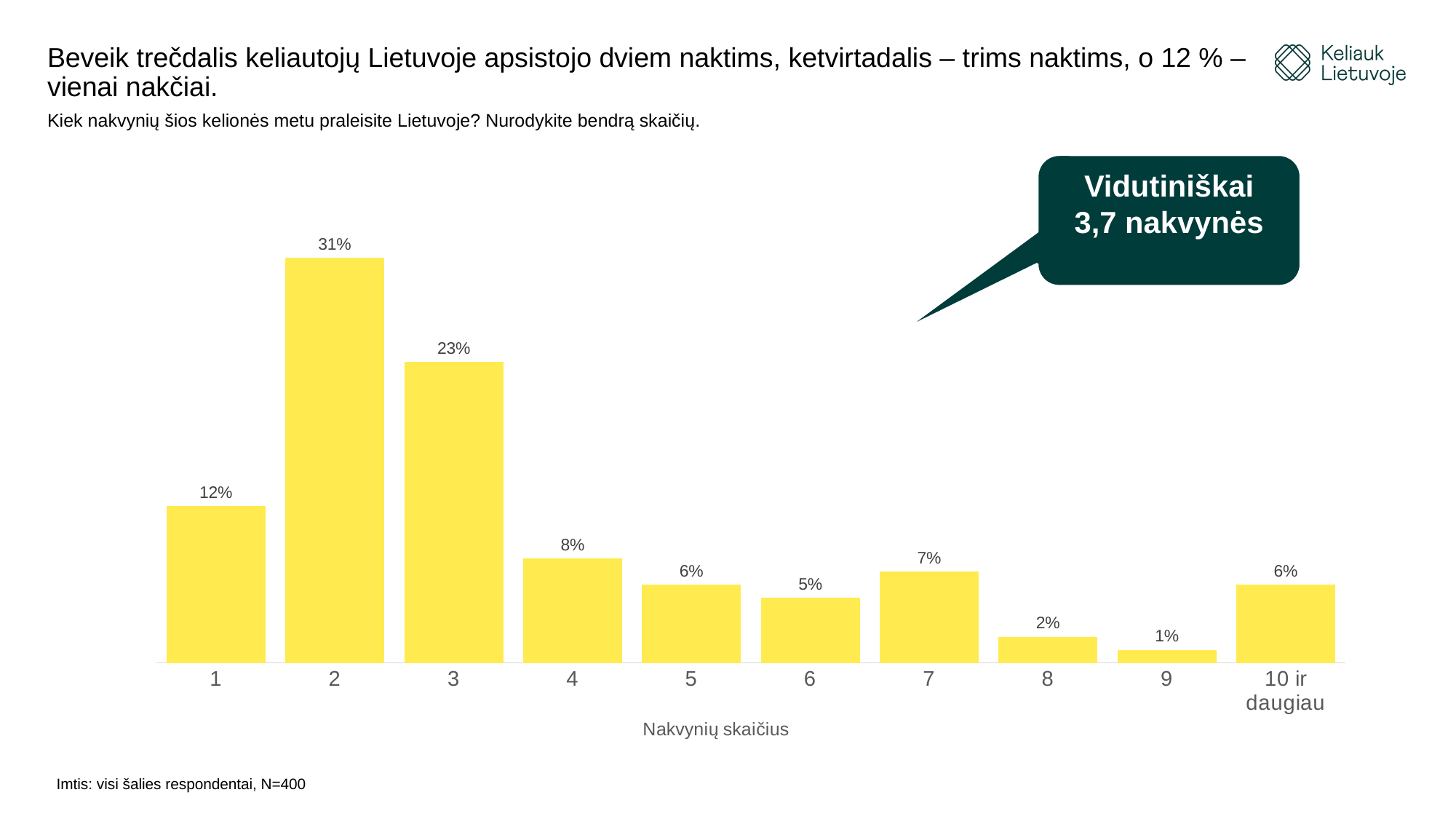
What is the value shown for 3 nights? 23% What is the combined percentage for 1, 2 and 3 nights? 66% What is the x-axis title of the chart? Nakvynių skaičius What is the difference between the percentages for 2 nights and 3 nights? 8% What percentage of travellers stayed 2 nights? 31% Which is larger, the value for 4 nights or the value for 7 nights? 4 nights Which category has the lowest percentage? 9 Which number of nights has the highest percentage? 2 What type of chart is shown on the slide? Bar chart How many categories are shown on the x axis? 10 What percentage is shown for the '10 ir daugiau' category? 6% What average number of nights is stated in the callout box? 3,7 nakvynės